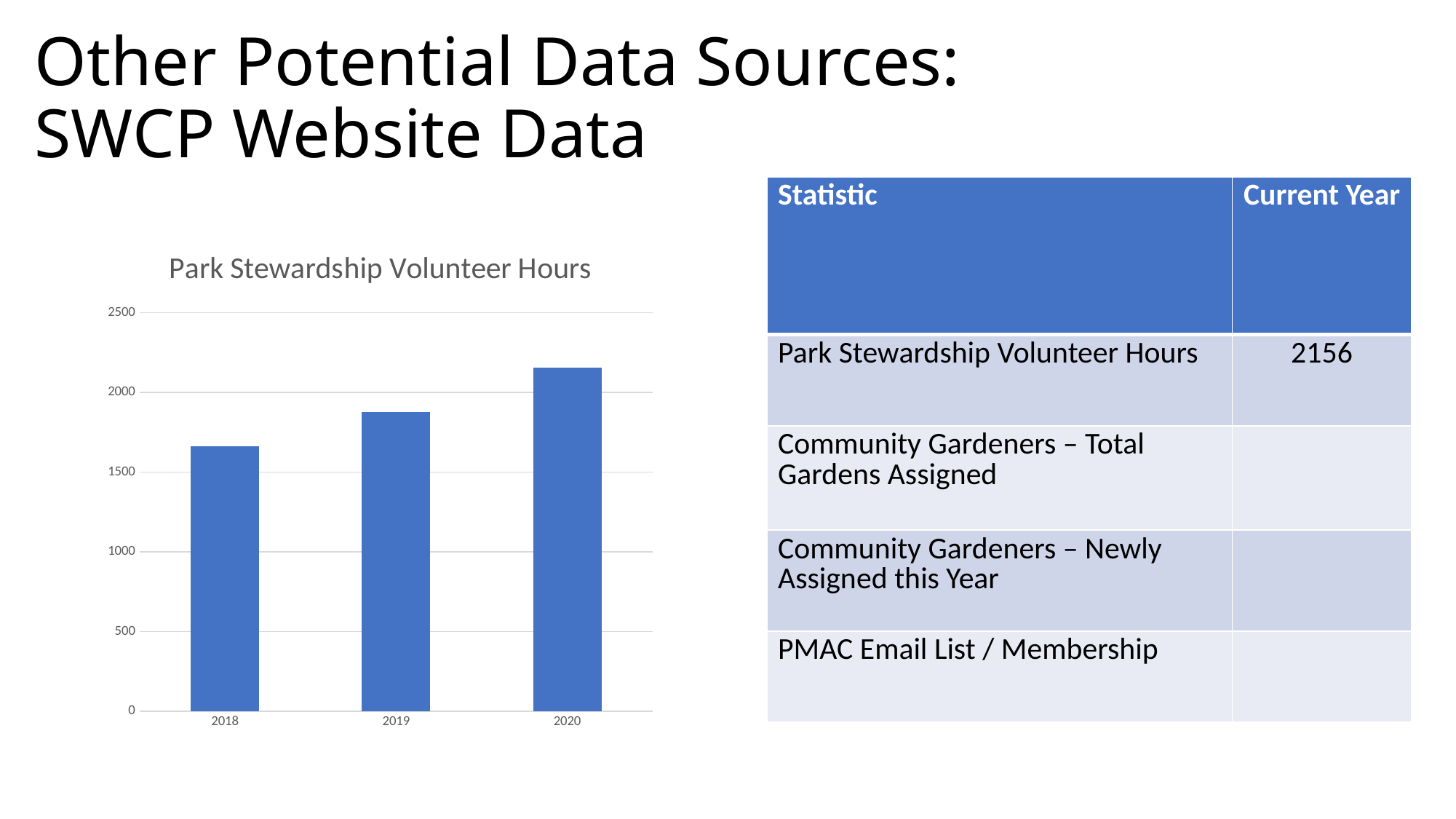
Which year has more volunteer hours, 2019 or 2020? 2020 Is the value for 2019 greater or less than 2000? less Which year has the highest bar in the chart? 2020 Do the volunteer hours rise or fall from 2018 to 2020? rise What is the title of the chart? Park Stewardship Volunteer Hours What is the highest value shown on the chart's vertical axis? 2500 Which year has the lowest bar in the chart? 2018 Which year has more volunteer hours, 2018 or 2019? 2019 What kind of chart is shown on the slide? bar chart How many years are shown on the x axis of the chart? 3 Is the value for 2020 greater or less than 2000? greater Is the value for 2018 greater or less than 1500? greater